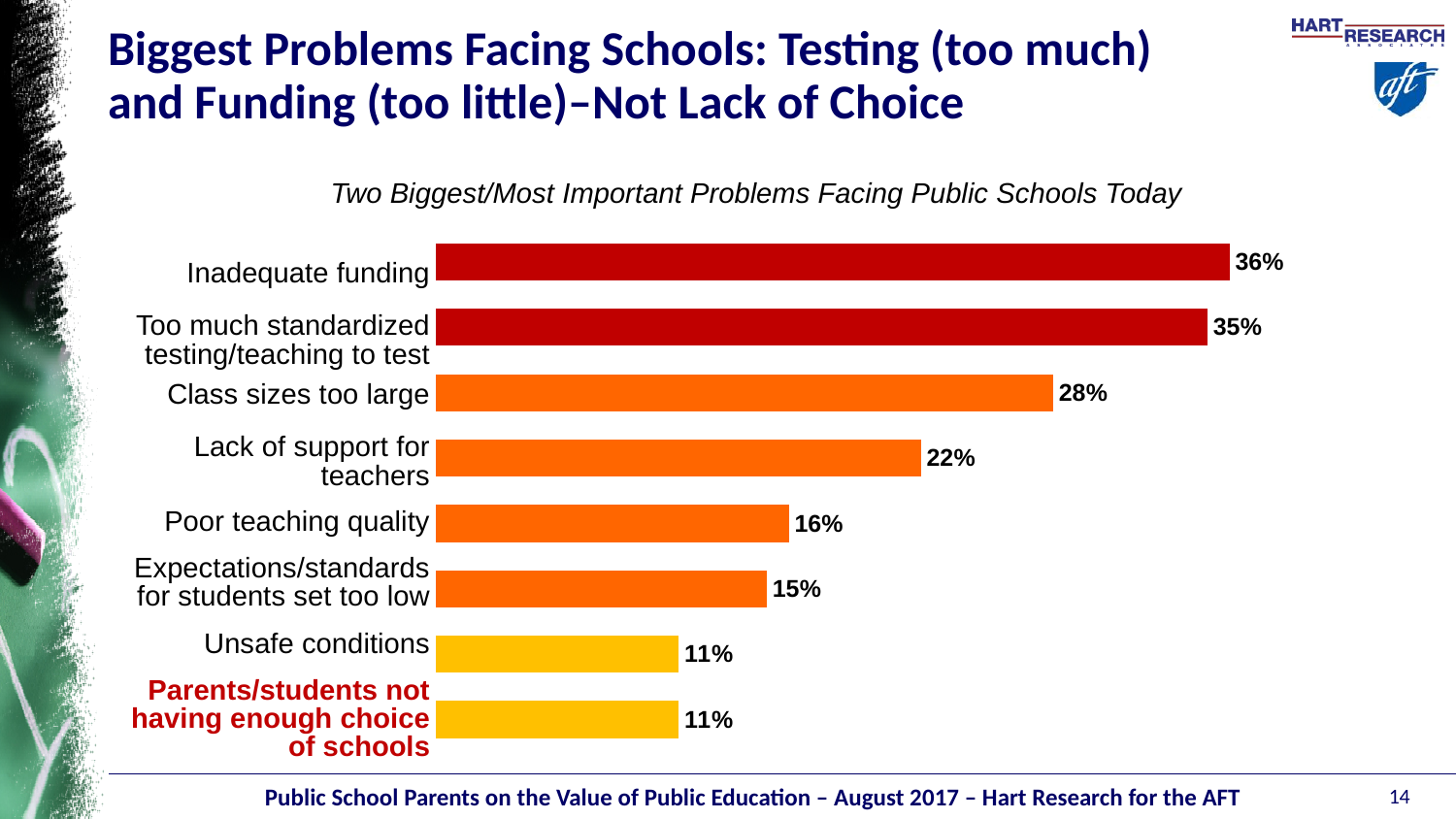
What percentage is shown for 'Parents/students not having enough choice of schools'? 11% Which category label is printed in red text? Parents/students not having enough choice of schools How many problem categories are shown in the chart? 8 Which has a higher value: 'Lack of support for teachers' or 'Unsafe conditions'? Lack of support for teachers What value is shown for 'Class sizes too large'? 28% What is the difference in percentage points between 'Class sizes too large' and 'Lack of support for teachers'? 6 What percentage of respondents named inadequate funding as one of the two biggest problems facing public schools? 36% Which has a higher value: 'Poor teaching quality' or 'Expectations/standards for students set too low'? Poor teaching quality Which problem has the highest percentage in the chart? Inadequate funding What is the title of the chart? Two Biggest/Most Important Problems Facing Public Schools Today What type of chart is shown on the slide? Bar chart What is the difference in percentage points between 'Inadequate funding' and 'Too much standardized testing/teaching to test'? 1